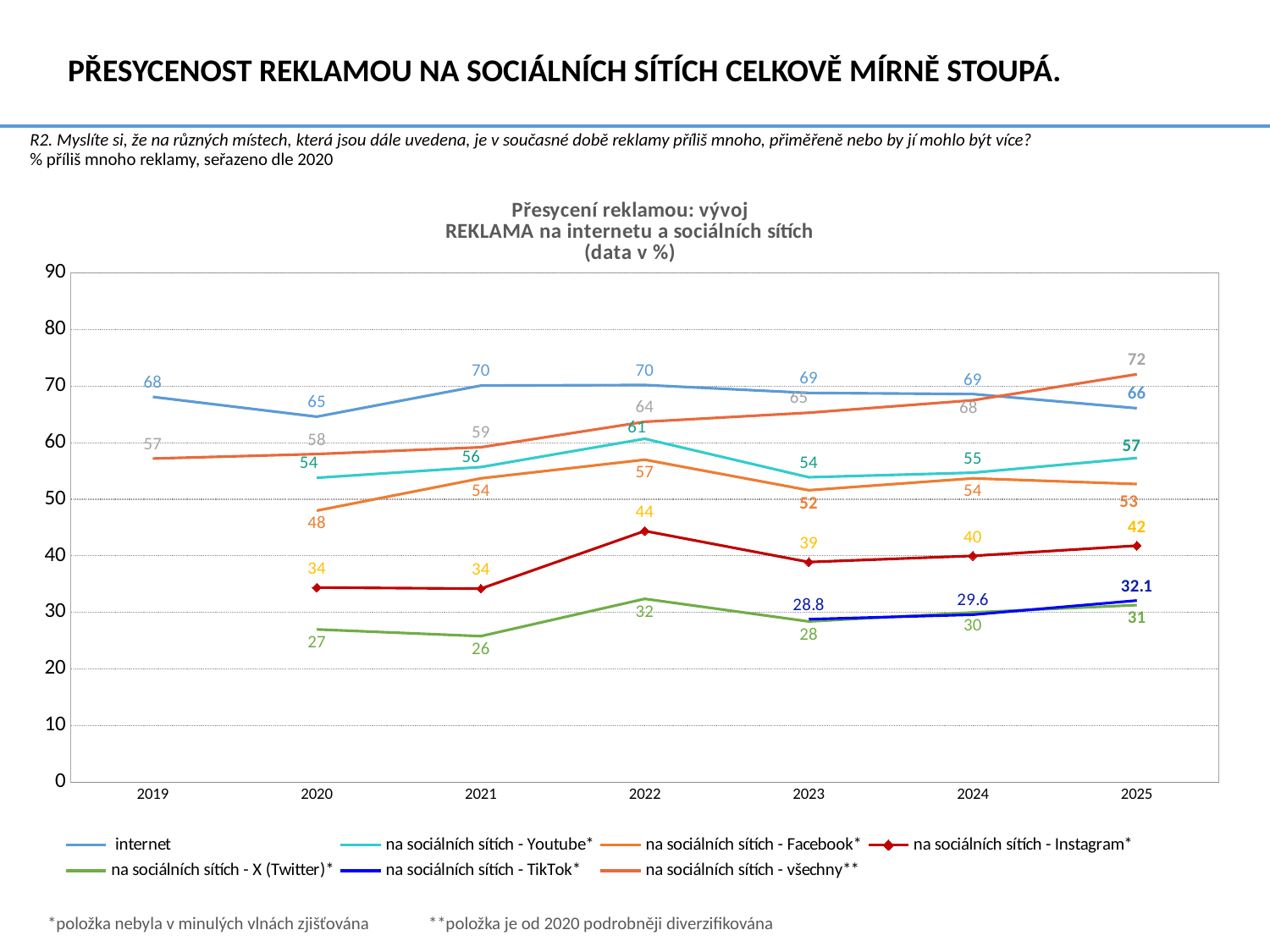
How many years are shown on the x axis? 7 What is the difference between 'na sociálních sítích - všechny**' and 'internet' in 2025? 6 In which year is the value for 'na sociálních sítích - X (Twitter)*' lowest? 2021 Is the value for 'na sociálních sítích - Facebook*' in 2020 greater or less than 50? less What is the value for 'na sociálních sítích - Instagram*' in 2022? 44 How many series does the legend list? 7 In 2025, which is larger: 'na sociálních sítích - Youtube*' or 'na sociálních sítích - Facebook*'? na sociálních sítích - Youtube* Does the value for 'na sociálních sítích - všechny**' rise or fall from 2019 to 2025? rise In which year does 'na sociálních sítích - všechny**' reach its highest value? 2025 What is the value for 'internet' in 2019? 68 What is the value for 'na sociálních sítích - TikTok*' in 2025? 32.1 What kind of chart is shown on the slide? line chart